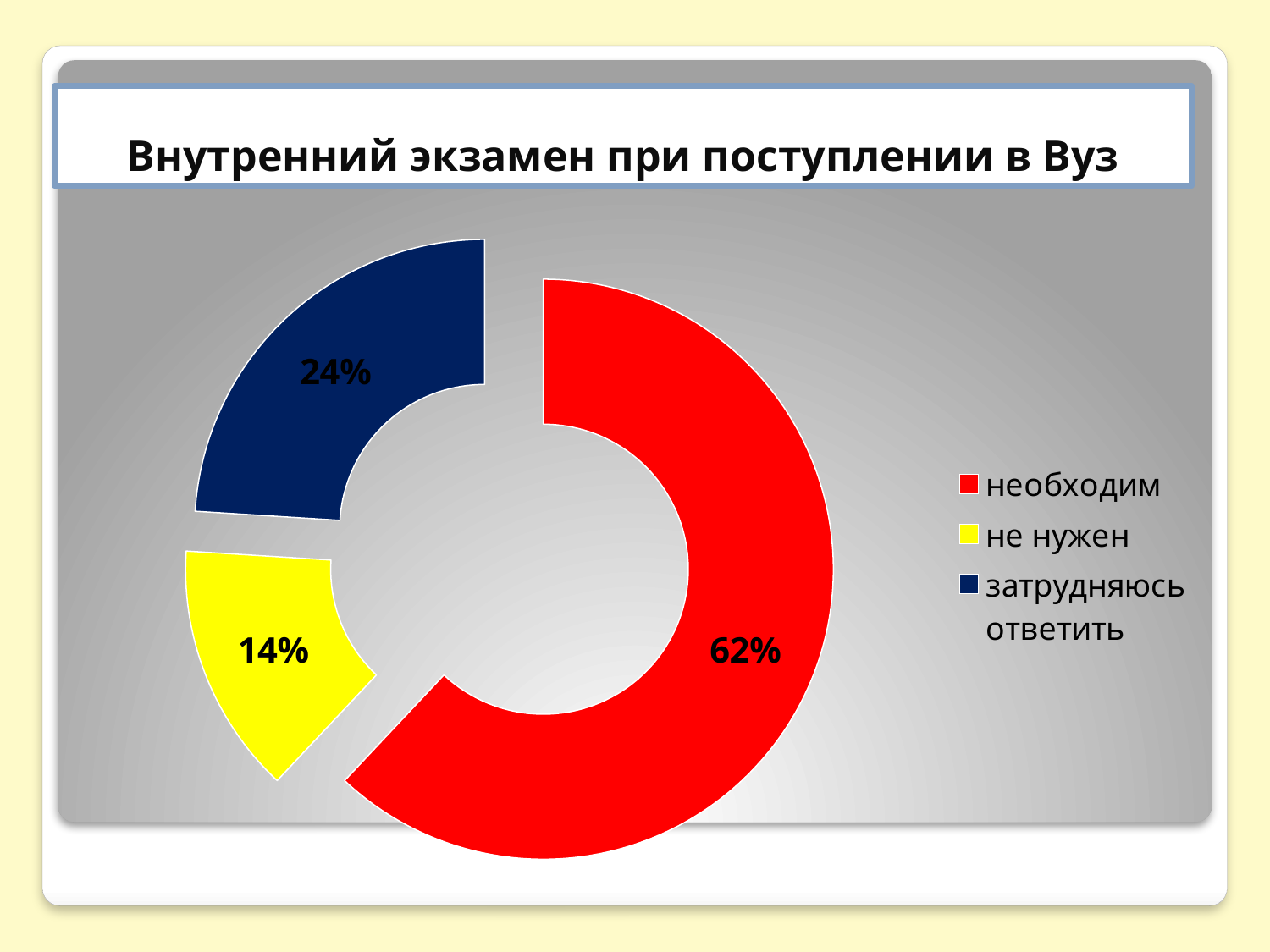
What is the title of the chart? Внутренний экзамен при поступлении в Вуз What share of the chart does the "затрудняюсь ответить" slice represent? 24% What is the difference in percentage points between the "необходим" and "затрудняюсь ответить" slices? 38 How many categories does the chart show? 3 What share of the chart does the "не нужен" slice represent? 14% What colour is the "не нужен" slice? Yellow Which category has the smallest share of the chart? не нужен What kind of chart is shown on the slide? Pie chart (doughnut) Which is larger: the share for "не нужен" or the share for "затрудняюсь ответить"? затрудняюсь ответить What is the difference in percentage points between the "затрудняюсь ответить" and "не нужен" slices? 10 What share of the chart does the "необходим" slice represent? 62% Which category has the largest share of the chart? необходим